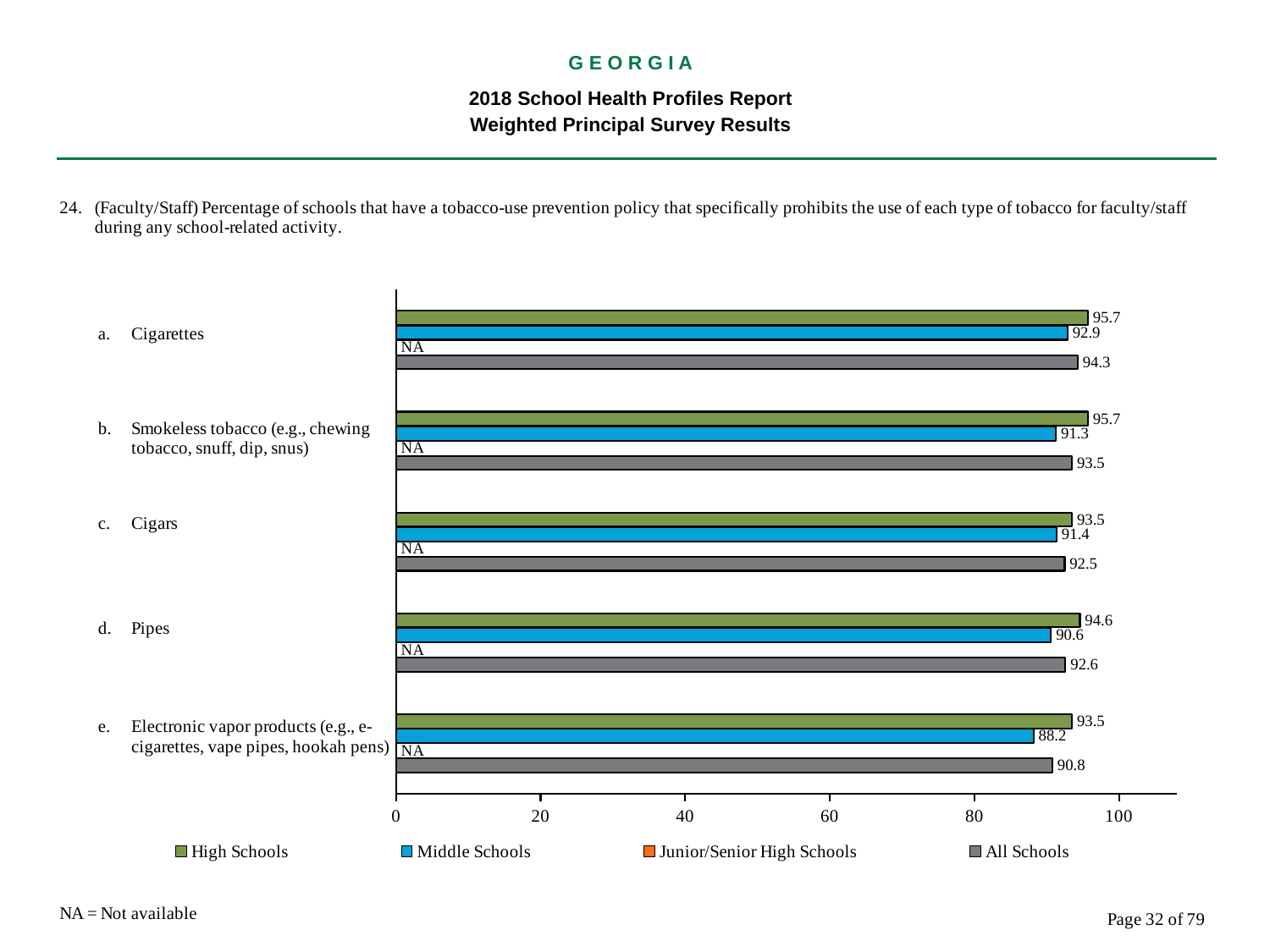
What is the value for Junior/Senior High Schools for Cigars? NA What is the value for All Schools for Pipes? 92.6 How many series does the legend list? 4 What is the value for High Schools for Cigarettes? 95.7 Which category has the lowest Middle Schools value? Electronic vapor products What is the difference between the High Schools and Middle Schools values for Smokeless tobacco? 4.4 How many categories are shown on the chart? 5 What is the value for Middle Schools for Electronic vapor products? 88.2 Which is larger for Pipes: the High Schools value or the All Schools value? High Schools What kind of chart is shown? bar chart Is the Middle Schools value for Electronic vapor products greater or less than 80? greater Which category has the highest All Schools value? Cigarettes